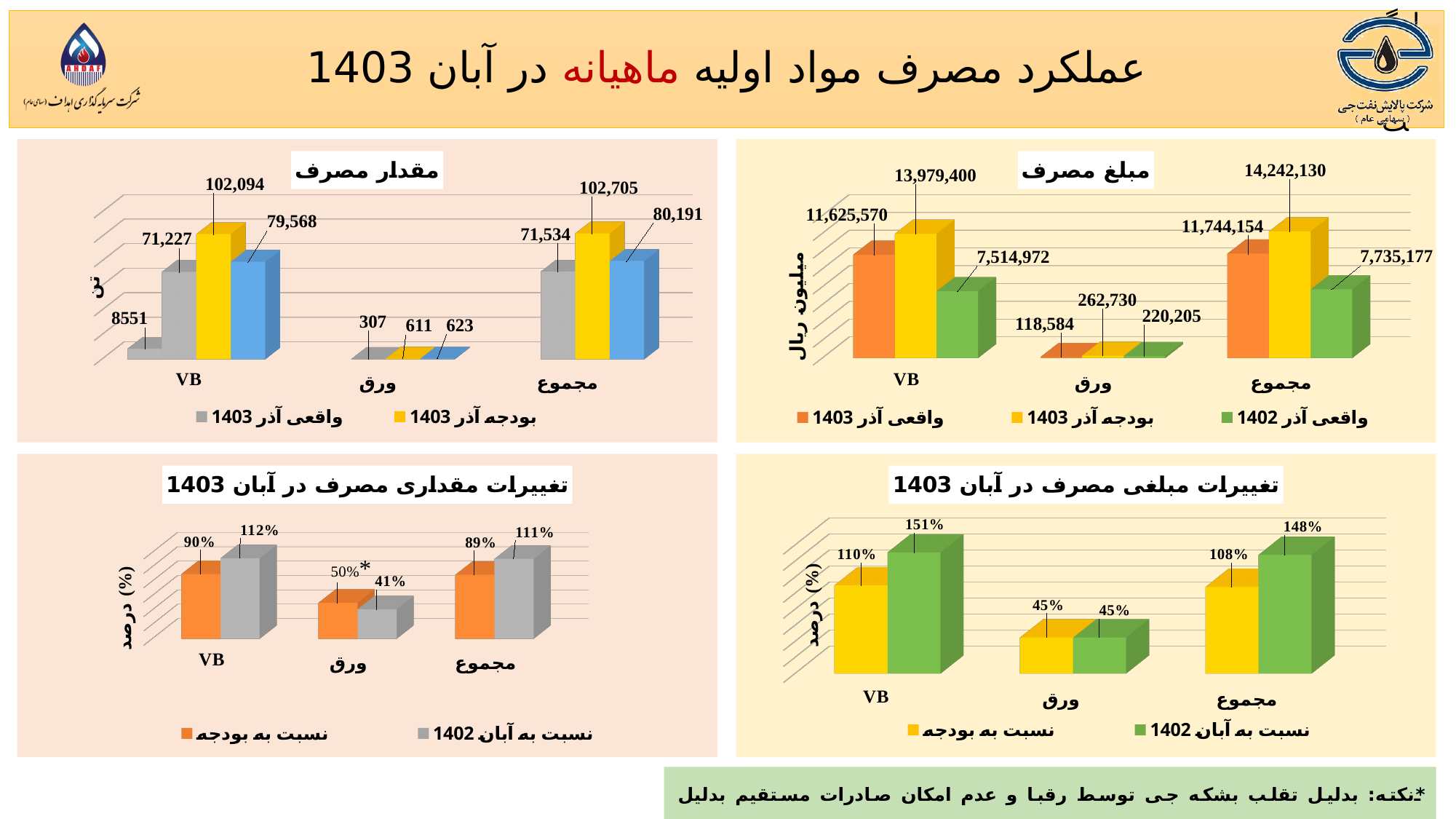
In the bottom-right chart (تغییرات مبلغی مصرف در آبان 1403), what is the value of نسبت به بودجه for مجموع? 108% In the top-right chart (مبلغ مصرف), which category has the lowest value for واقعی آذر 1403? ورق In the bottom-right chart (تغییرات مبلغی مصرف در آبان 1403), which category has the highest value for نسبت به آبان 1402? VB In the top-right chart (مبلغ مصرف), what is the value of واقعی آذر 1402 for مجموع? 7,735,177 In the top-left chart (مقدار مصرف), what is the value of واقعی آذر 1403 for مجموع? 71,534 What kind of chart is the bottom-right chart (تغییرات مبلغی مصرف در آبان 1403)? Bar chart In the top-right chart (مبلغ مصرف), what is the difference between بودجه آذر 1403 and واقعی آذر 1403 for ورق? 144,146 In the top-left chart (مقدار مصرف), what is the value of بودجه آذر 1403 for ورق? 611 In the bottom-left chart (تغییرات مقداری مصرف در آبان 1403), which is larger for ورق: نسبت به بودجه or نسبت به آبان 1402? نسبت به بودجه In the top-right chart (مبلغ مصرف), what is the value of بودجه آذر 1403 for VB? 13,979,400 In the bottom-left chart (تغییرات مقداری مصرف در آبان 1403), what is the value of نسبت به آبان 1402 for VB? 112% How many series does the legend of the top-right chart (مبلغ مصرف) list? 3